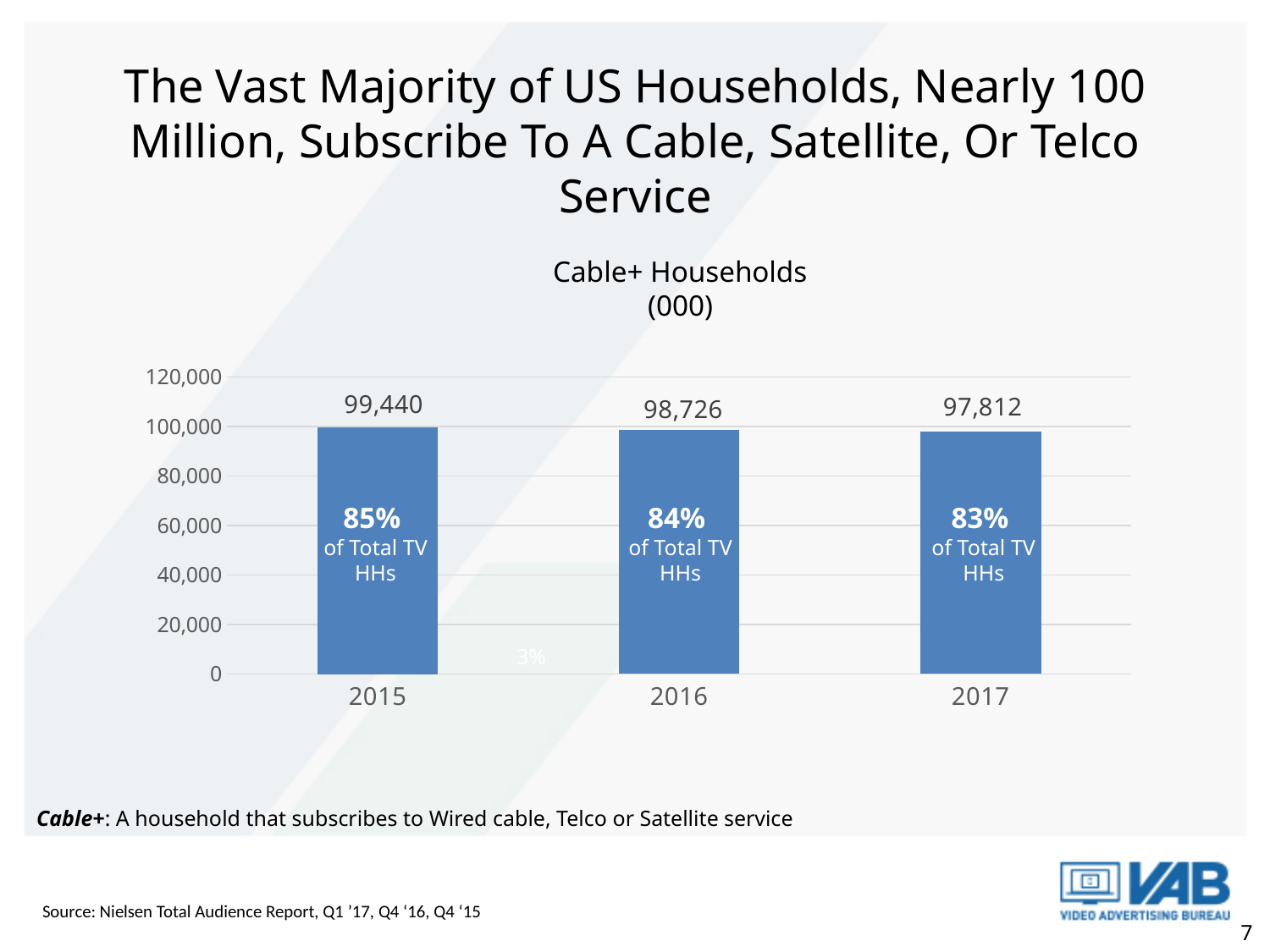
What kind of chart is shown on the slide? bar chart Do the Cable+ Households values rise or fall from 2015 to 2017? fall What is the difference between the 2015 and 2017 values for Cable+ Households? 1,628 Which year has the highest number of Cable+ Households? 2015 How many years are shown in the Cable+ Households chart? 3 What is the value for 2017 in the Cable+ Households chart? 97,812 Which year has the lowest number of Cable+ Households? 2017 What is the value for 2015 in the Cable+ Households chart? 99,440 What is the value for 2016 in the Cable+ Households chart? 98,726 What is the difference between the 2015 and 2016 values for Cable+ Households? 714 Which is larger, the value for 2016 or the value for 2017? 2016 Is the value for 2017 greater or less than 100,000? less